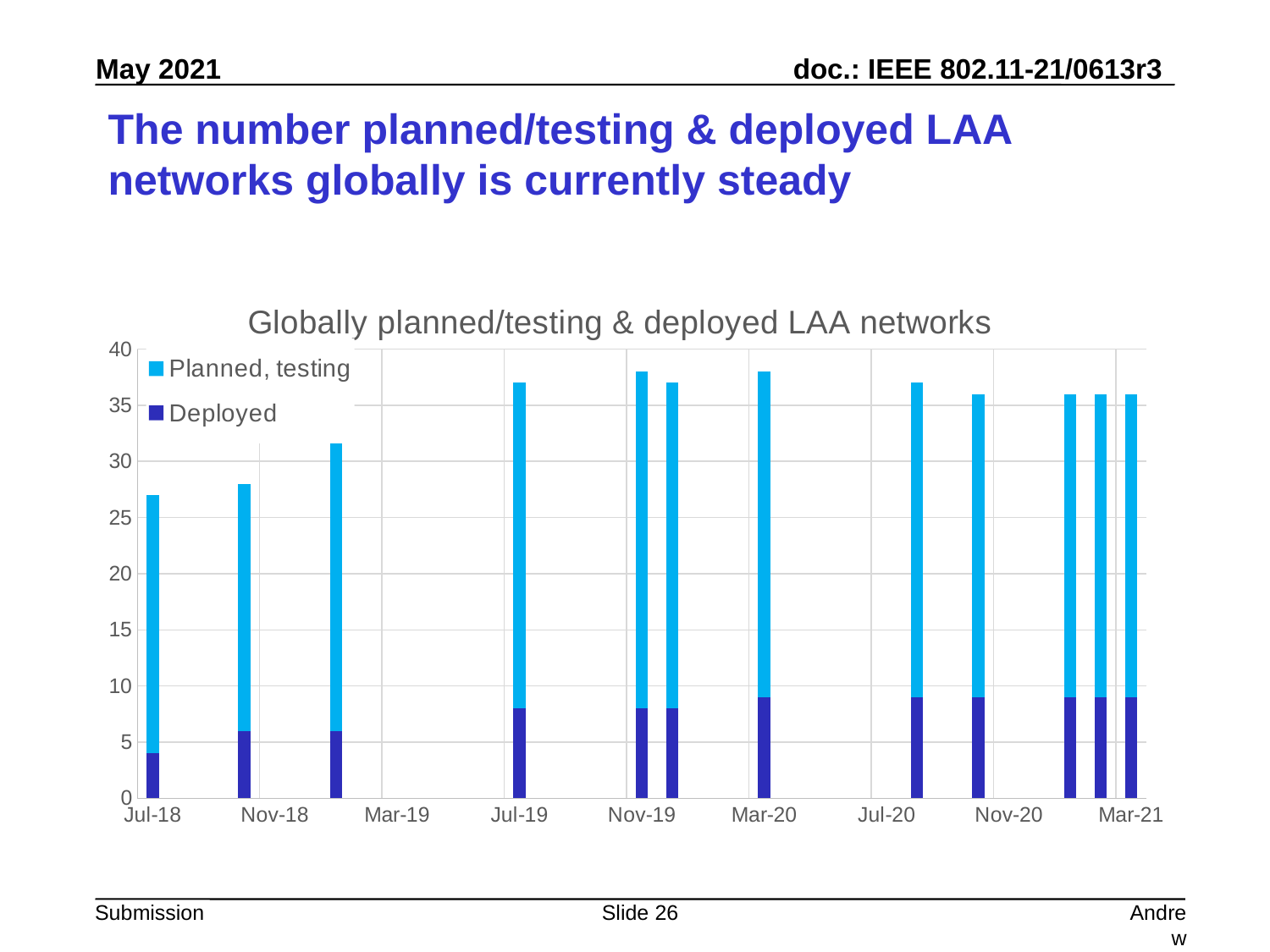
How many series does the chart legend list? 2 Which bar has the larger Deployed value, Jul-18 or Mar-20? Mar-20 Which series is shown in dark blue in the chart? Deployed What kind of chart is shown on the slide? Stacked bar chart Is the total height of the bar at Jul-19 greater or less than 35? greater Is the Deployed value at Mar-20 greater or less than 10? less Which bar is taller in total, the one at Jul-18 or the one at Jul-19? Jul-19 How many bars are plotted in the chart? 12 Is the total height of the bar at Mar-21 greater or less than 30? greater What is the title of the chart? Globally planned/testing & deployed LAA networks Do the total bar heights generally rise or fall from Jul-18 to Jul-19? rise